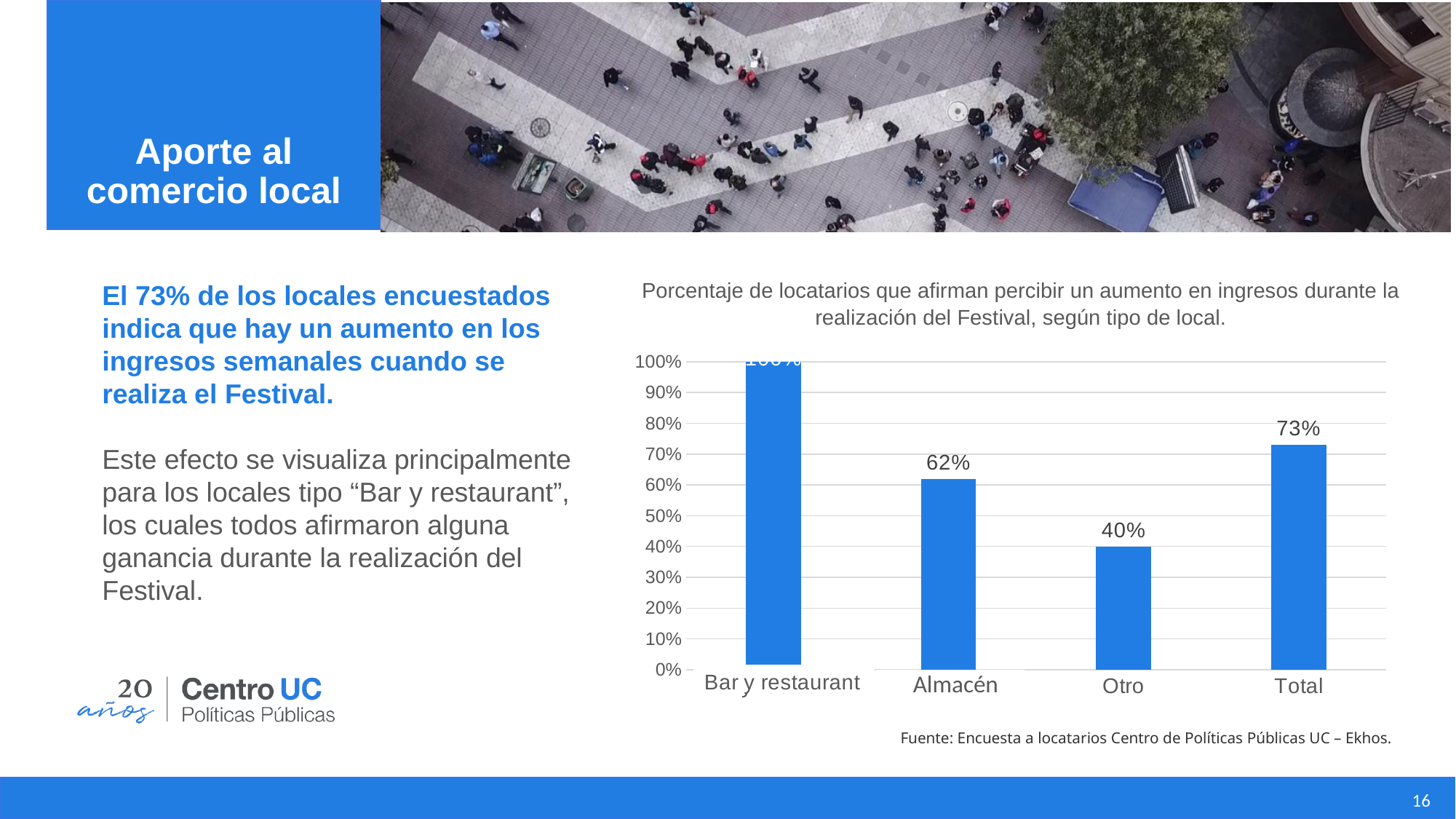
How many categories are shown on the x axis of the chart? 4 Which is larger, the value for Almacén or the value for Total? Total What is the difference between the values for Almacén and Otro? 22% Which type of local has the highest percentage reporting an increase in income? Bar y restaurant What is the value shown for Bar y restaurant? 100% What is the source cited below the chart? Encuesta a locatarios Centro de Políticas Públicas UC – Ekhos What is the value shown for Otro? 40% What percentage of Almacén locatarios report an increase in income during the Festival? 62% What is the difference between the Total value and the Almacén value? 11% What is the value shown for Total? 73% Which category has the lowest value in the chart? Otro What kind of chart is shown on the slide? Bar chart